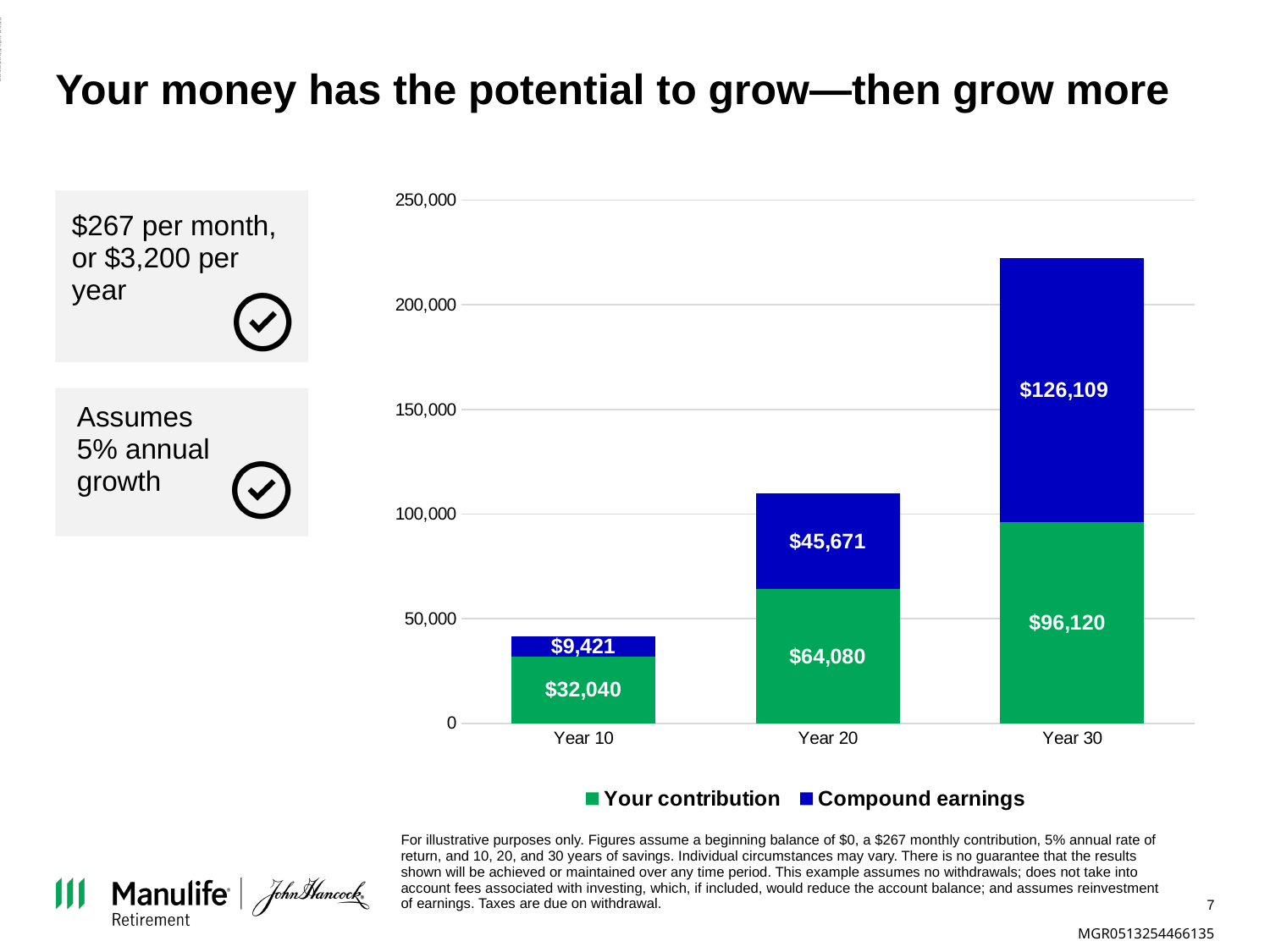
What is the value of Compound earnings for Year 10? $9,421 Is the total stacked bar for Year 30 greater or less than 200,000? greater What is the total of the stacked bar for Year 20? $109,751 What kind of chart is shown on the slide? Stacked bar chart How many series does the legend list? 2 What is the value of Compound earnings for Year 30? $126,109 Which year has the lowest Your contribution? Year 10 What is the value of Your contribution for Year 20? $64,080 How many categories are shown on the x axis? 3 What is the difference between Your contribution for Year 30 and Year 10? $64,080 Which year has the highest Compound earnings? Year 30 For Year 30, which is larger: Your contribution or Compound earnings? Compound earnings